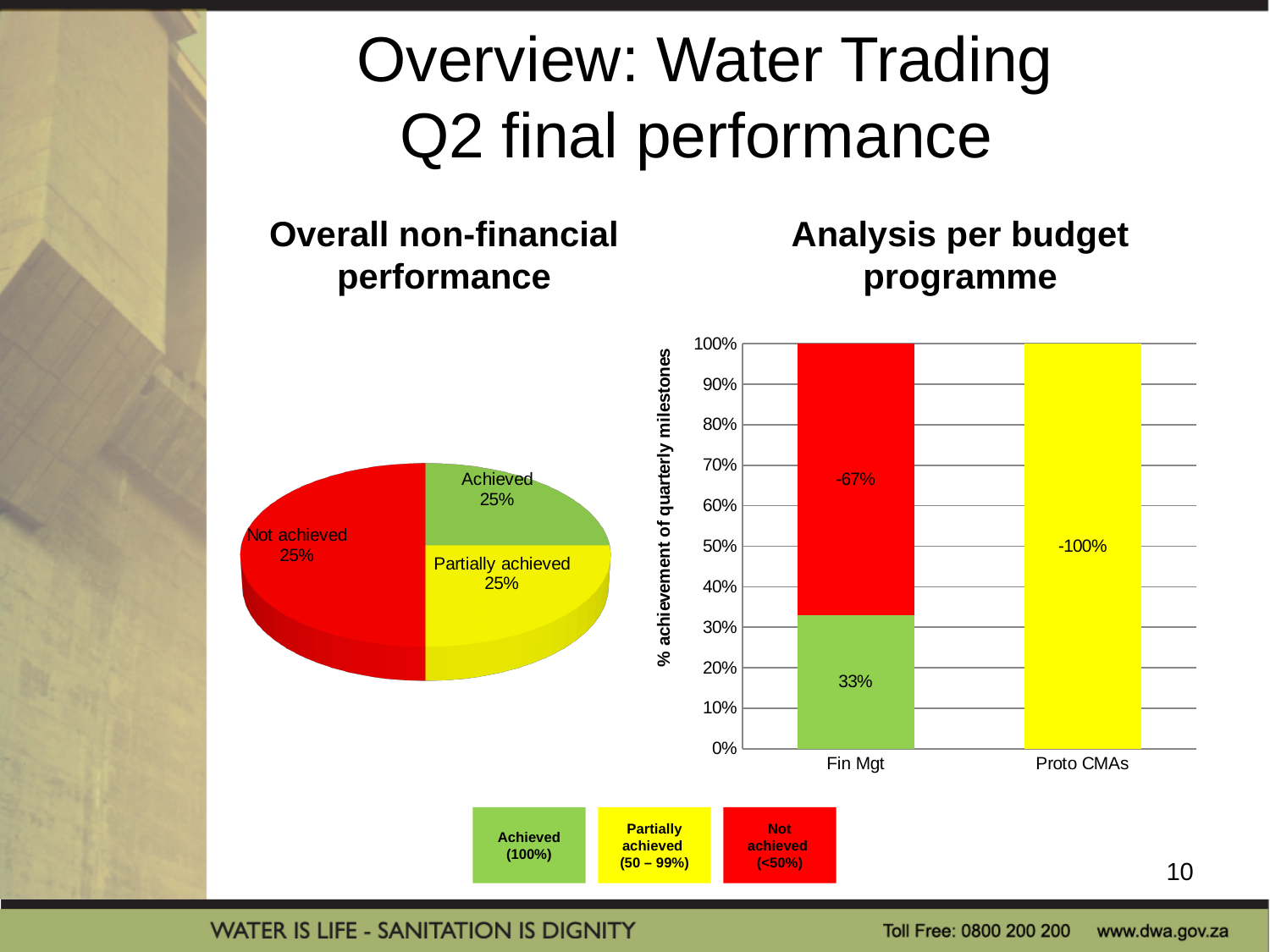
How many slices does the 'Overall non-financial performance' pie chart have? 3 In the 'Analysis per budget programme' chart, is the green (Achieved) portion of the Fin Mgt bar greater or less than 50%? less In the 'Analysis per budget programme' chart, what value is printed on the red segment of the Fin Mgt bar? -67% In the 'Overall non-financial performance' pie chart, what percentage is printed for the 'Partially achieved' slice? 25% What kind of chart is 'Overall non-financial performance'? Pie chart In the 'Analysis per budget programme' chart, what value is printed on the green segment of the Fin Mgt bar? 33% In the 'Overall non-financial performance' pie chart, what percentage is printed for the 'Achieved' slice? 25% In the 'Analysis per budget programme' chart, what value is printed on the Proto CMAs bar? -100% How many budget programmes are shown on the x axis of the 'Analysis per budget programme' chart? 2 How many categories does the legend at the bottom of the slide list? 3 In the 'Overall non-financial performance' pie chart, what label is printed on the red slice? Not achieved 25% What kind of chart is 'Analysis per budget programme'? Bar chart